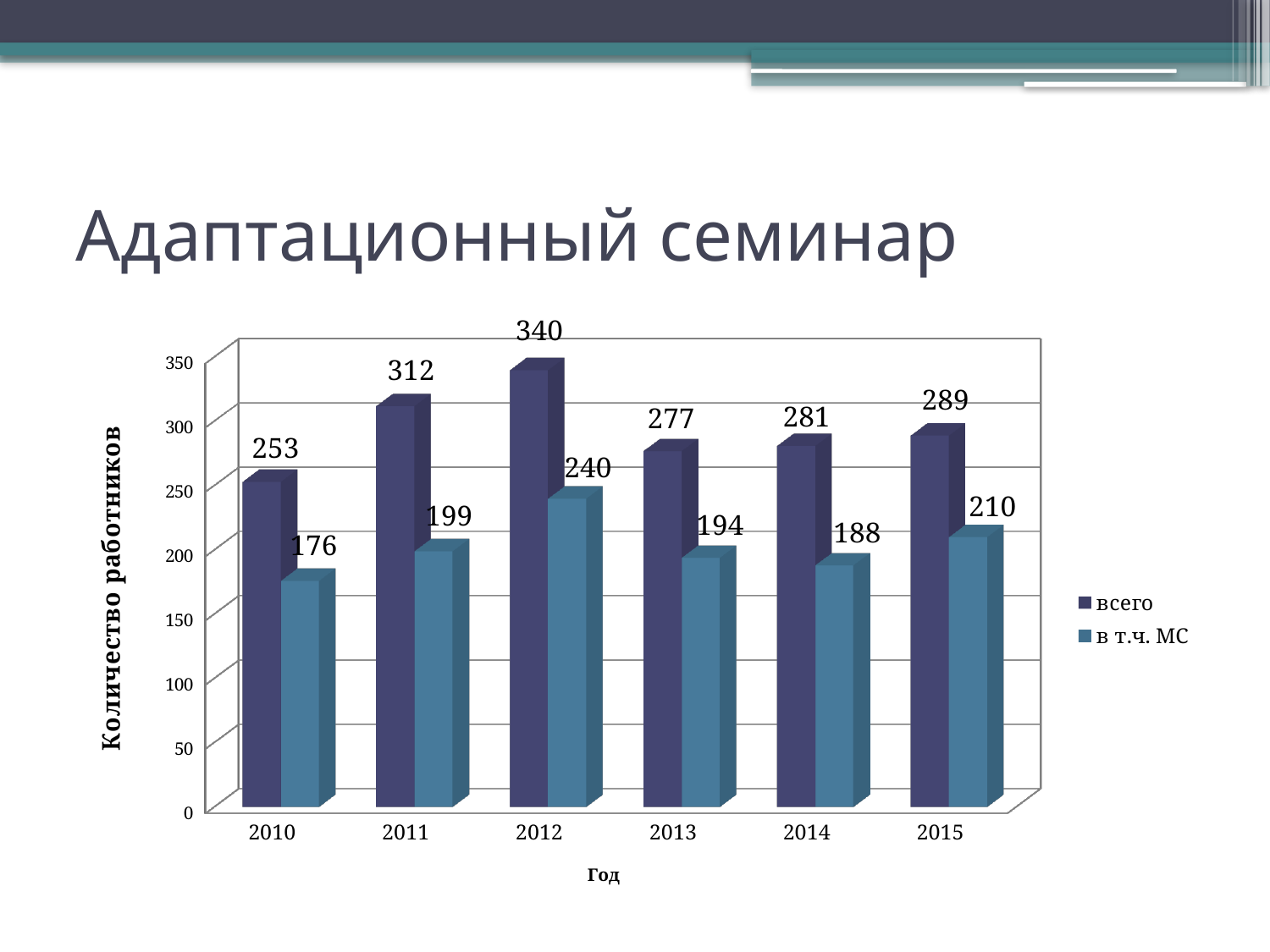
How many years are shown on the x axis? 6 What is the difference between the 'всего' and 'в т.ч. МС' values for 2013? 83 What is the value of the 'в т.ч. МС' series for 2015? 210 What is the value of the 'всего' series for 2012? 340 What is the value of the 'в т.ч. МС' series for 2010? 176 In which year is the 'в т.ч. МС' value lowest? 2010 What is the label of the y axis? Количество работников Which is larger: the 'всего' value for 2014 or for 2015? 2015 What kind of chart is shown on the slide? bar chart How many series does the legend list? 2 Does the 'всего' series rise or fall from 2010 to 2012? rise In which year is the 'всего' value highest? 2012